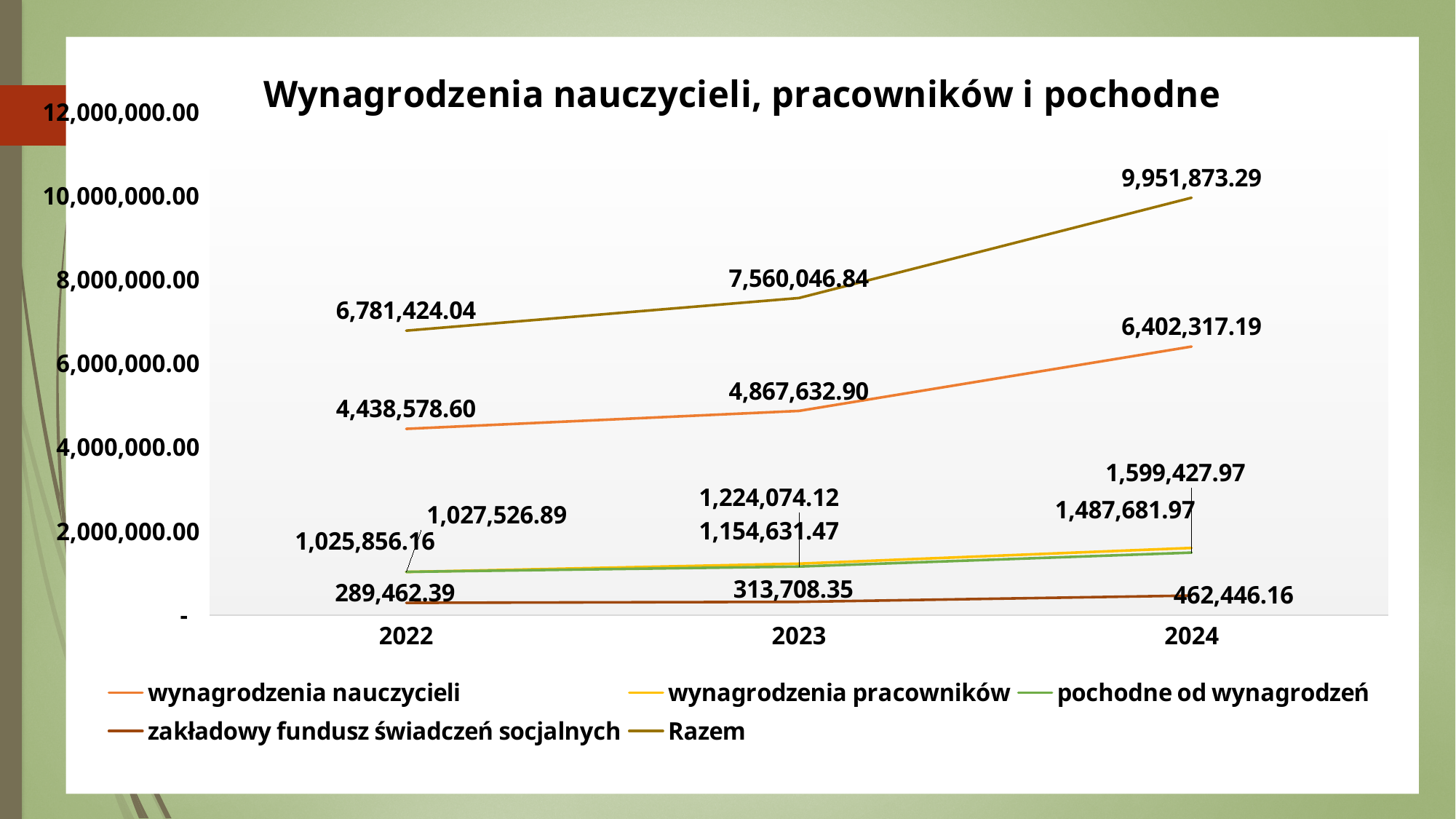
What kind of chart is shown on the slide? line chart Is the value of Razem in 2022 greater or less than 6,000,000.00? greater By how much did Razem increase from 2022 to 2024? 3,170,449.25 How many series does the legend list? 5 Which is larger in 2024: wynagrodzenia nauczycieli or zakładowy fundusz świadczeń socjalnych? wynagrodzenia nauczycieli What is the value of Razem in 2023? 7,560,046.84 What is the value of zakładowy fundusz świadczeń socjalnych in 2023? 313,708.35 What is the value of wynagrodzenia nauczycieli in 2022? 4,438,578.60 What is the difference between wynagrodzenia nauczycieli in 2024 and in 2023? 1,534,684.29 In which year is the Razem series highest? 2024 What is the value of Razem in 2024? 9,951,873.29 In which year is wynagrodzenia nauczycieli lowest? 2022